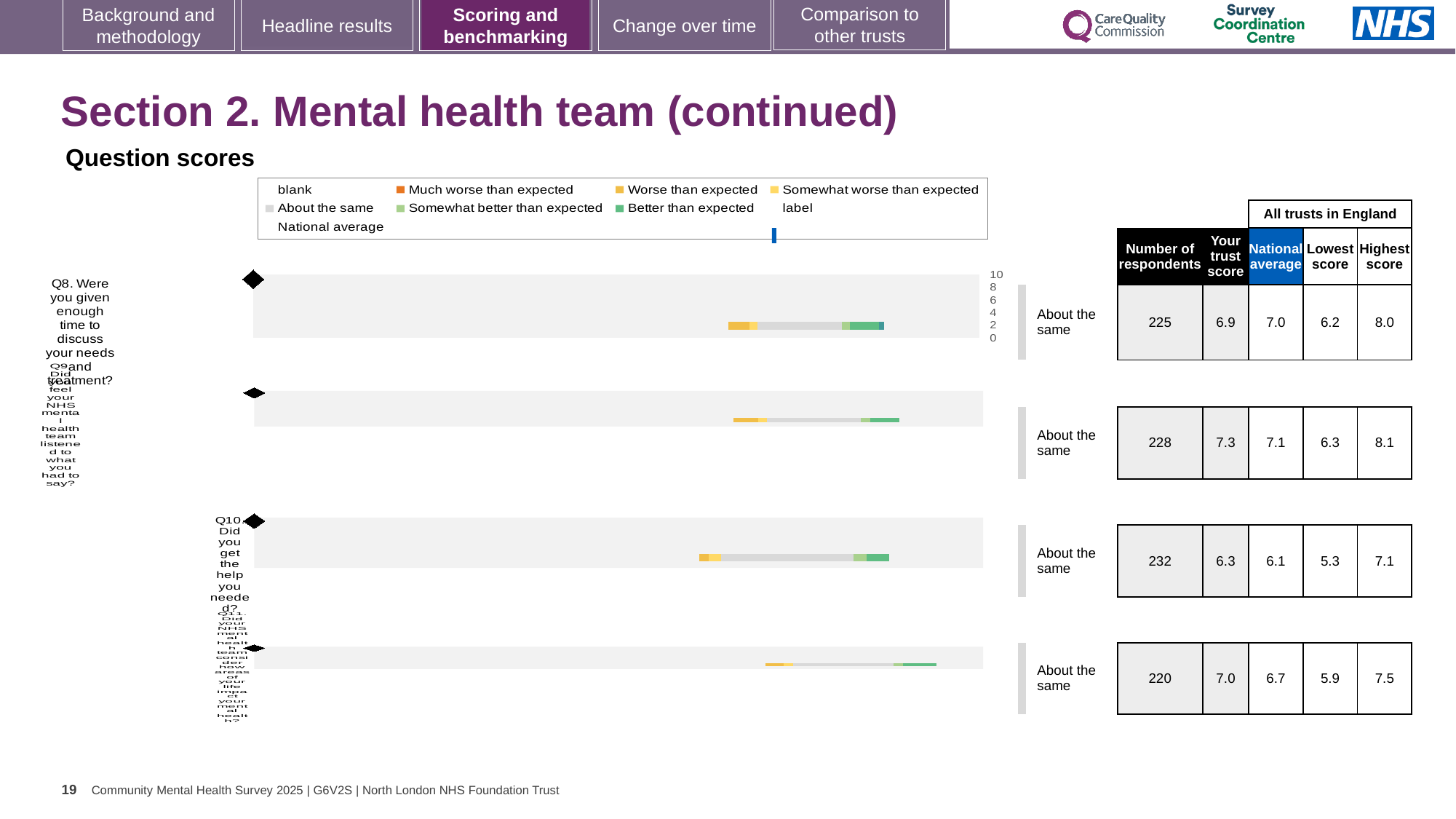
What is the highest score across all trusts in England shown for Q11? 7.5 For Q11, what is the difference between the trust score and the national average? 0.3 How many respondents are listed for Q8 (Were you given enough time to discuss your needs and treatment?)? 225 What is the 'Your trust score' value shown for Q9? 7.3 What kind of chart is used to show the question scores on this slide? Bar chart What is the national average shown for Q10 (Did you get the help you needed?)? 6.1 Which question on the slide has the highest 'Your trust score'? Q9 For Q9, which is larger: the trust score or the national average? Trust score What is the lowest score across all trusts in England shown for Q8? 6.2 What benchmark rating label is shown next to the Q10 bar? About the same Which question on the slide has the lowest 'Your trust score'? Q10 How many questions (bars) are charted on this slide? 4